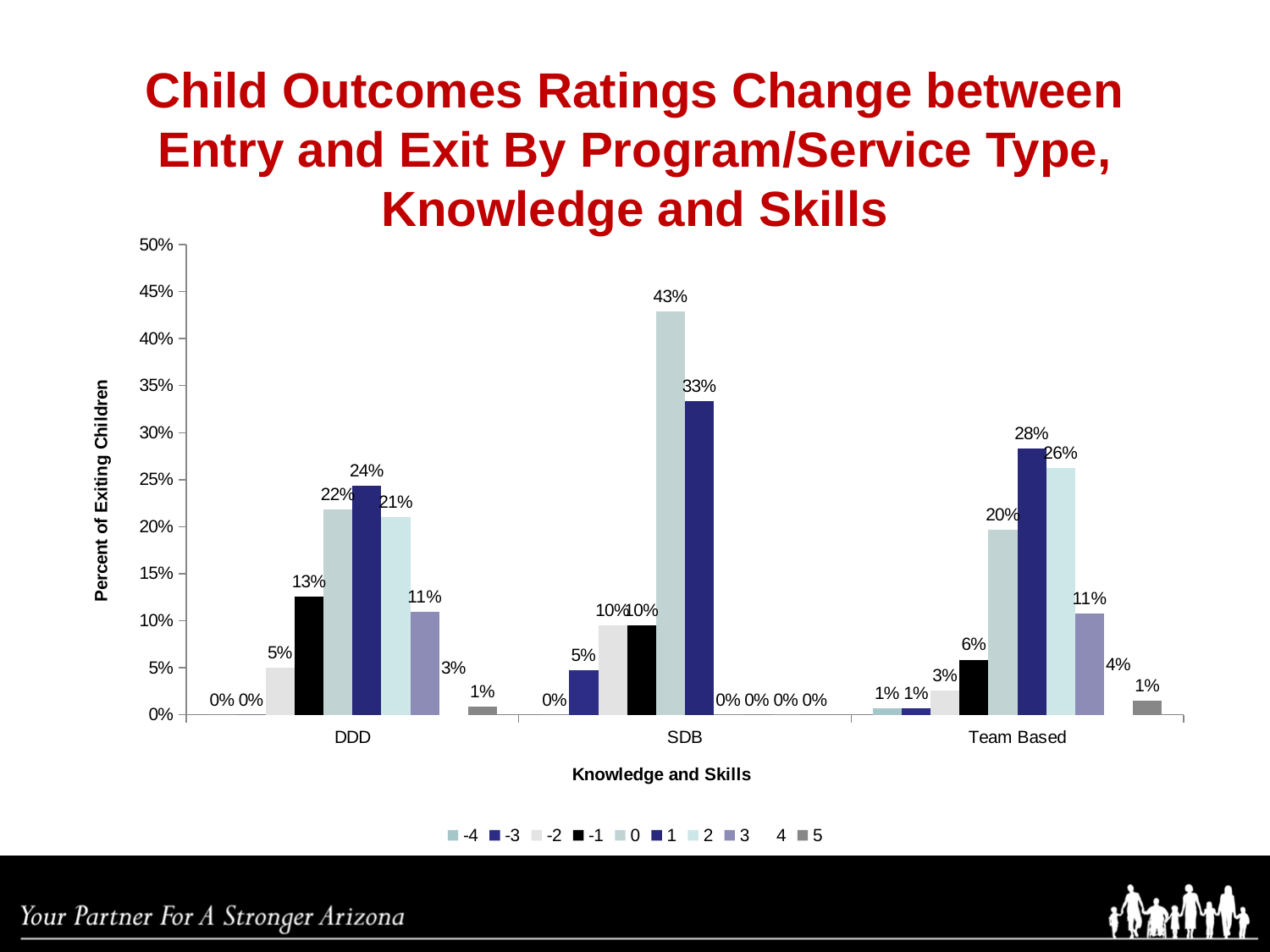
Which program/service type has the lowest value for a rating change of 1? DDD What percent of exiting children in the Team Based group had a rating change of 2? 26% Is the value for a rating change of 1 larger for Team Based or for DDD? Team Based How many series does the legend list? 10 What percent of exiting children in the SDB group had a rating change of 0? 43% Which program/service type has the highest value for a rating change of 0? SDB What is the label of the y axis? Percent of Exiting Children How many program/service types are shown on the x axis? 3 What kind of chart is shown on the slide? Bar chart What percent of exiting children in the DDD group had a rating change of -1? 13% What percent of exiting children in the DDD group had a rating change of 1? 24% What is the difference between the SDB values for rating changes of 0 and 1? 10%